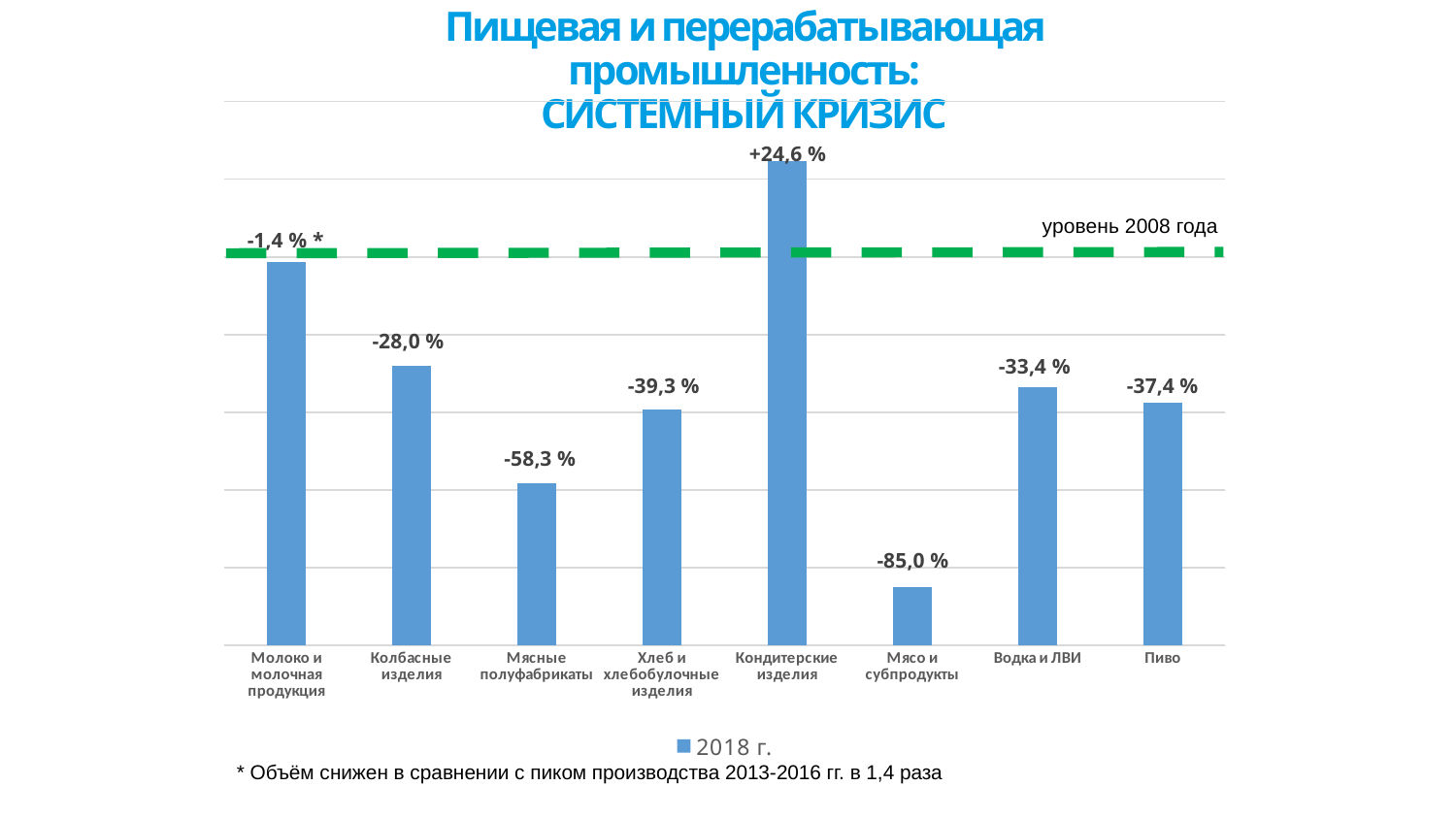
Which category has the highest bar? Кондитерские изделия How many series does the legend list? 1 What is the data label for Кондитерские изделия? +24,6 % What kind of chart is shown on the slide? Bar chart Which bar is taller: Колбасные изделия or Хлеб и хлебобулочные изделия? Колбасные изделия What is the data label for Водка и ЛВИ? -33,4 % What is the difference in percentage points between the labels for Водка и ЛВИ (-33,4 %) and Пиво (-37,4 %)? 4,0 percentage points Which category has the lowest bar? Мясо и субпродукты What does the green dashed horizontal line represent? уровень 2008 года How many categories are shown on the x axis? 8 What is the data label for Мясные полуфабрикаты? -58,3 % What is the data label for Мясо и субпродукты? -85,0 %